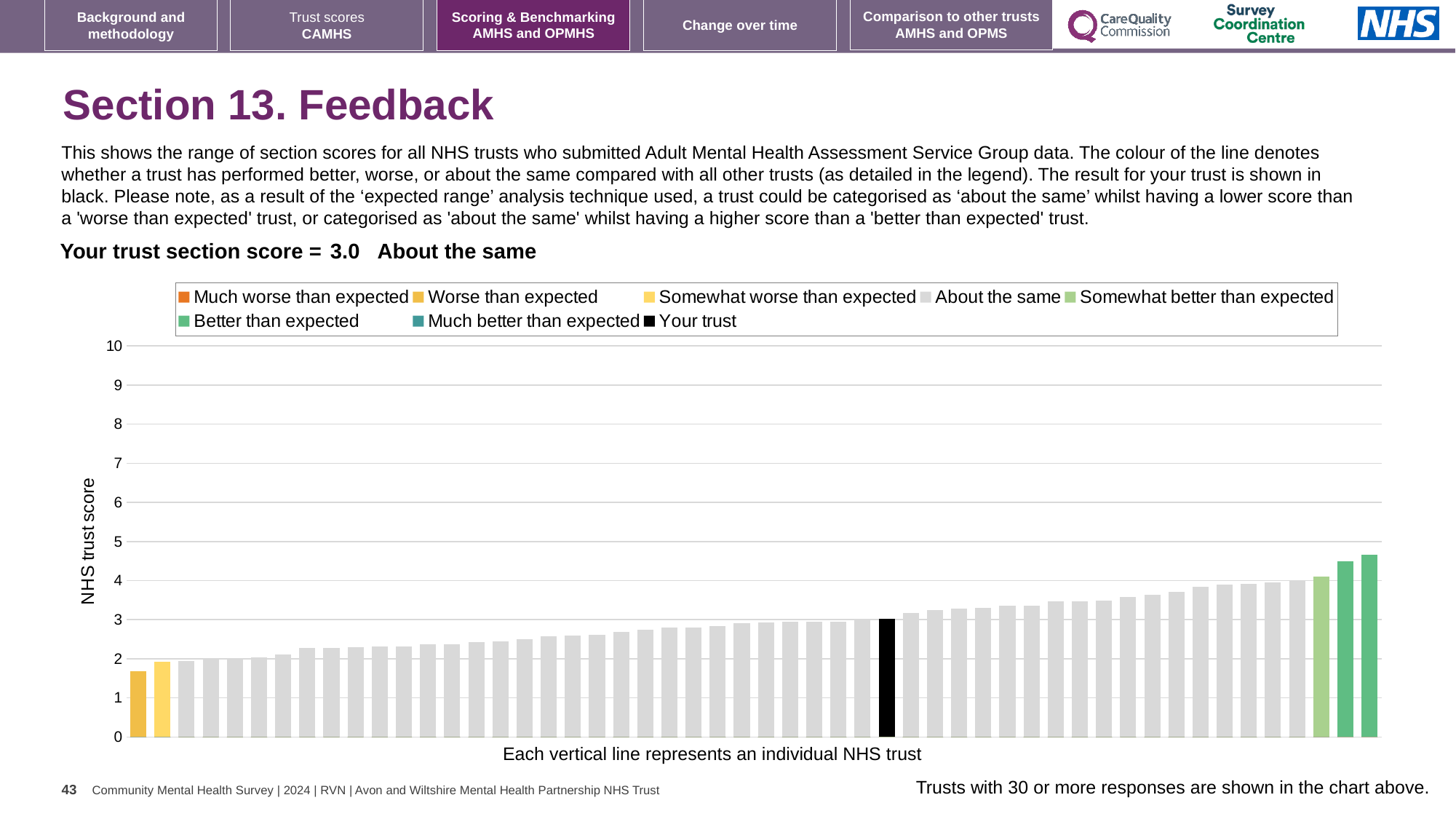
Is the value for your trust greater or less than 2? greater What kind of chart is shown on the slide? Bar chart What is the label on the vertical axis of the chart? NHS trust score What is the section score for your trust? 3.0 Which category is your trust placed in for this section? About the same Is the value of the highest bar greater or less than 4? greater Is the value of the lowest bar greater or less than 2? less Do the bar values rise or fall from left to right along the x axis? rise Which legend category does the highest bar belong to? Better than expected How many entries does the chart legend list? 8 What colour is the bar representing your trust? Black